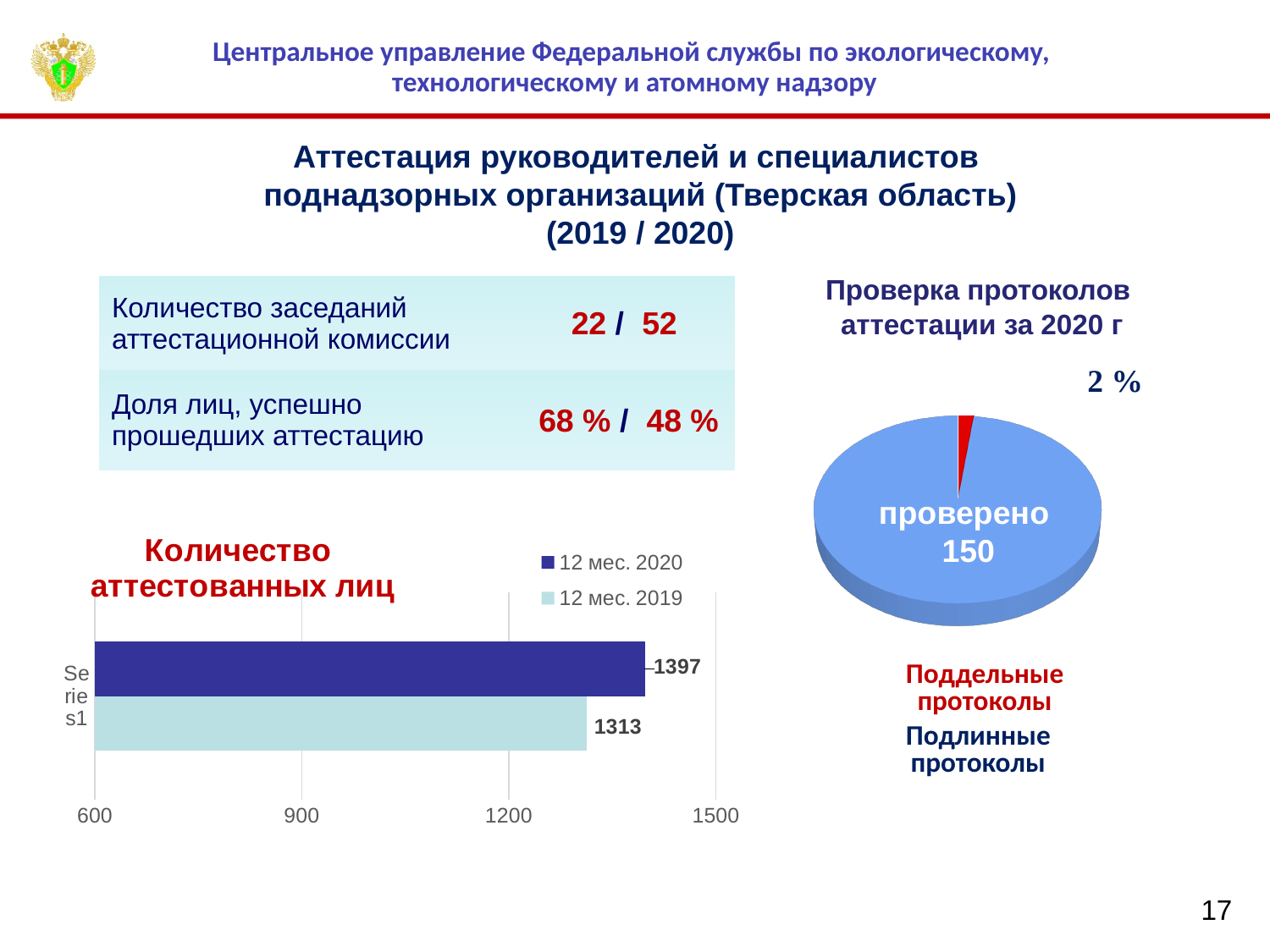
In the bar chart 'Количество аттестованных лиц', what is the difference between the 12 мес. 2020 value and the 12 мес. 2019 value? 84 In the bar chart 'Количество аттестованных лиц', what is the value for 12 мес. 2019? 1313 In the bar chart 'Количество аттестованных лиц', is the value for 12 мес. 2019 greater or less than 1200? greater In the bar chart 'Количество аттестованных лиц', what is the value for 12 мес. 2020? 1397 In the bar chart 'Количество аттестованных лиц', which series has the higher value, 12 мес. 2020 or 12 мес. 2019? 12 мес. 2020 In the bar chart 'Количество аттестованных лиц', what is the highest value shown on the x axis? 1500 In the pie chart 'Проверка протоколов аттестации за 2020 г', which category is the largest slice? Подлинные протоколы What kind of chart is 'Проверка протоколов аттестации за 2020 г'? pie chart In the pie chart 'Проверка протоколов аттестации за 2020 г', what share of the pie is labelled for Поддельные протоколы? 2 % In the pie chart 'Проверка протоколов аттестации за 2020 г', how many protocols were checked according to the label on the pie? 150 What kind of chart is 'Количество аттестованных лиц'? bar chart In the bar chart 'Количество аттестованных лиц', how many series does the legend list? 2